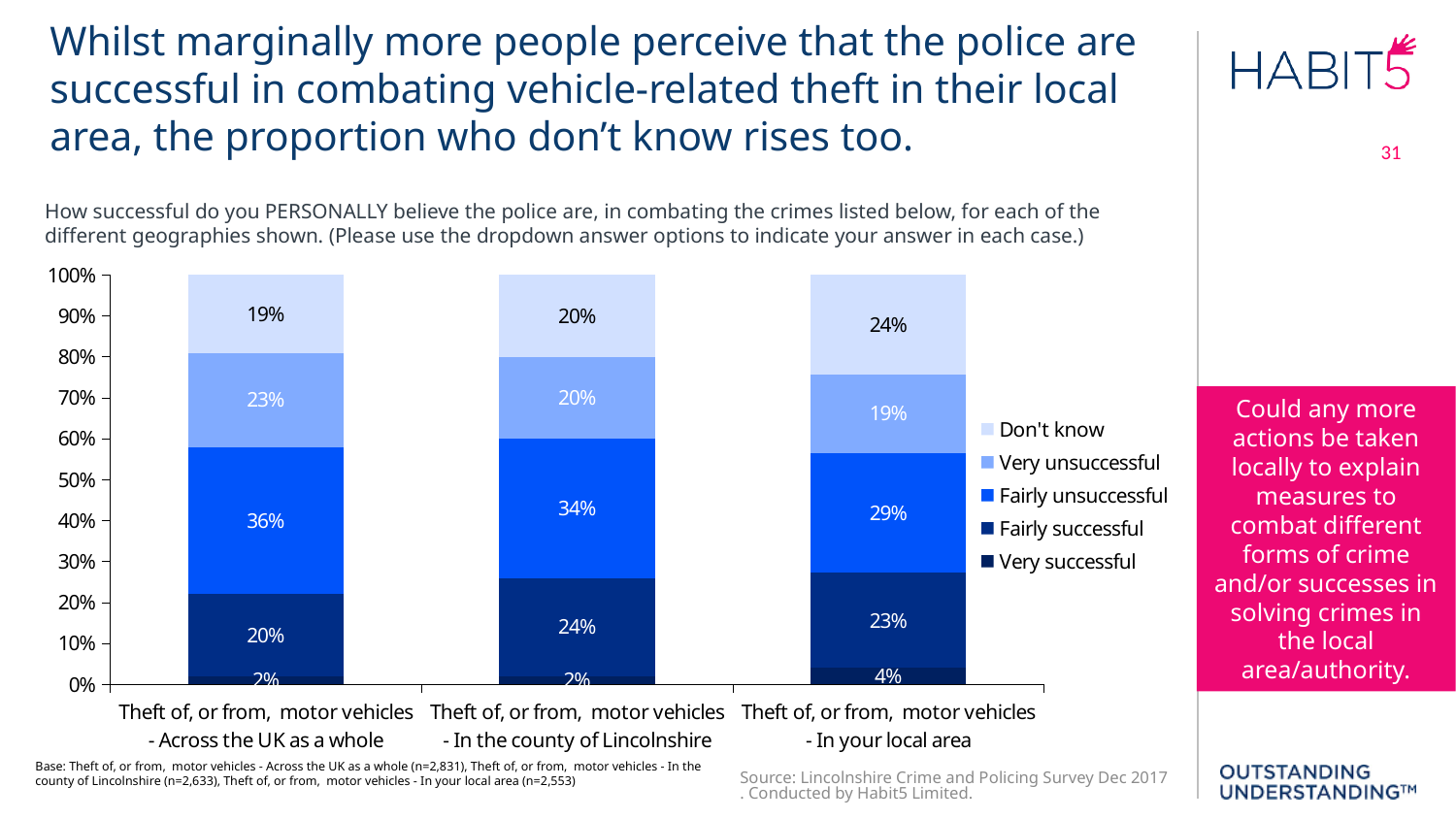
How many series does the legend list? 5 How many geography categories are shown on the x axis? 3 What percentage of respondents answered 'Don't know' for theft of, or from, motor vehicles in your local area? 24% Which geography has the lowest 'Fairly unsuccessful' percentage? In your local area What percentage of respondents said the police are 'Very successful' at combating theft of, or from, motor vehicles in the county of Lincolnshire? 2% Is the 'Very unsuccessful' percentage higher across the UK as a whole or in the county of Lincolnshire? Across the UK as a whole What type of chart is shown on the slide? Stacked bar chart What is the combined percentage of 'Very successful' and 'Fairly successful' responses for theft of, or from, motor vehicles in your local area? 27% What percentage of respondents said the police are 'Fairly successful' at combating theft of, or from, motor vehicles in your local area? 23% Which geography has the highest 'Don't know' percentage? In your local area What is the difference between the 'Fairly unsuccessful' percentage across the UK as a whole and in your local area? 7 percentage points What percentage of respondents said the police are 'Fairly unsuccessful' at combating theft of, or from, motor vehicles across the UK as a whole? 36%